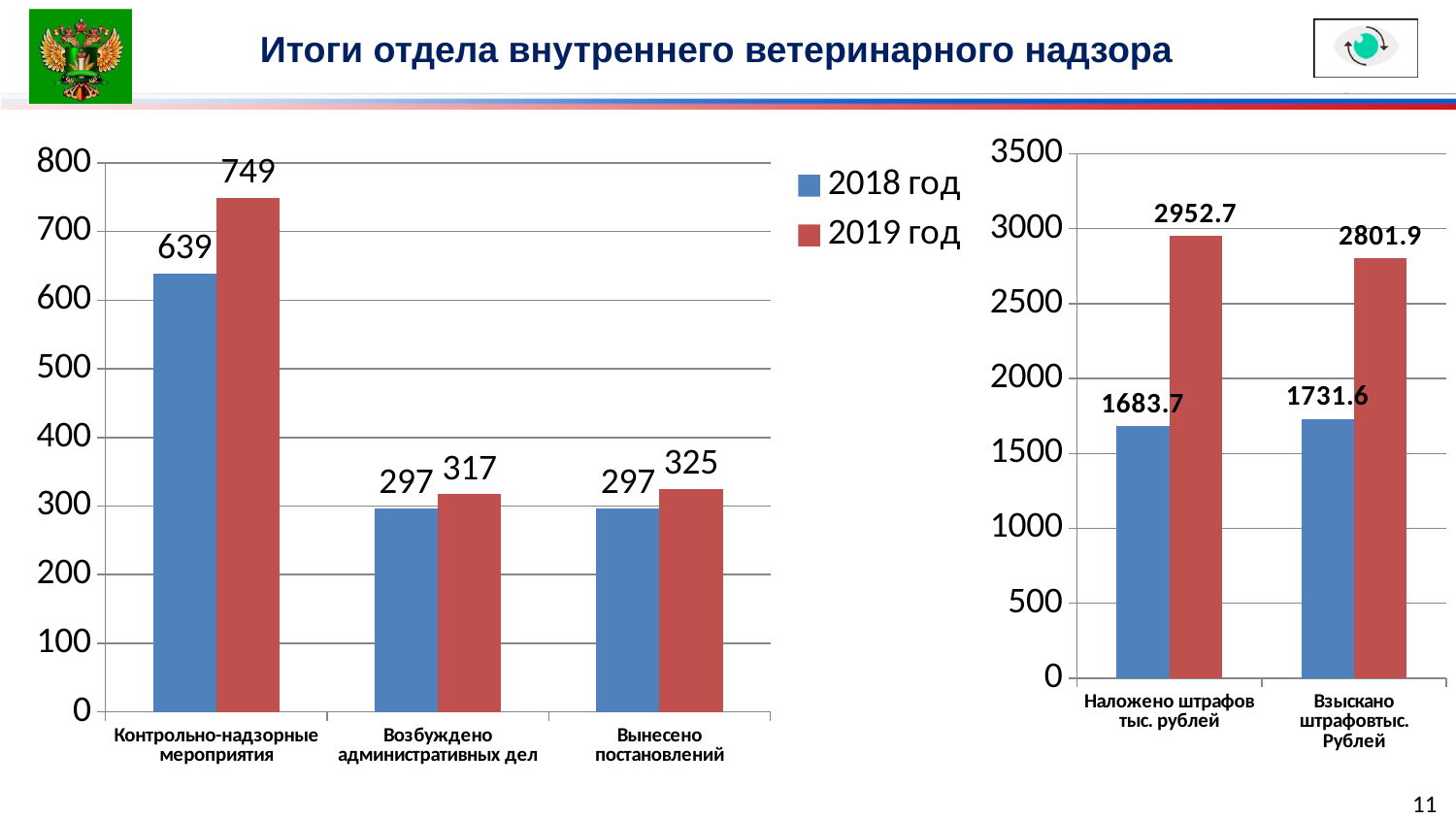
In the left chart, what is the value for 2018 год for Вынесено постановлений? 297 In the right chart, what is the value of the red bar for Наложено штрафов тыс. рублей? 2952.7 In the left chart, what is the difference between the 2019 год and 2018 год values for Контрольно-надзорные мероприятия? 110 In the left chart, which colour represents 2018 год in the legend? blue In the left chart, what is the value for 2019 год for Контрольно-надзорные мероприятия? 749 In the left chart, which category has the highest value for 2019 год? Контрольно-надзорные мероприятия In the right chart, what is the value of the blue bar for Взыскано штрафов тыс. рублей? 1731.6 In the right chart, what is the difference between the red and blue bars for Взыскано штрафов тыс. рублей? 1070.3 In the left chart, how many series does the legend list? 2 What kind of chart is the right chart? bar chart In the left chart, which is larger: the 2019 год value for Возбуждено административных дел or the 2019 год value for Вынесено постановлений? Вынесено постановлений In the left chart, how many categories are shown on the x axis? 3